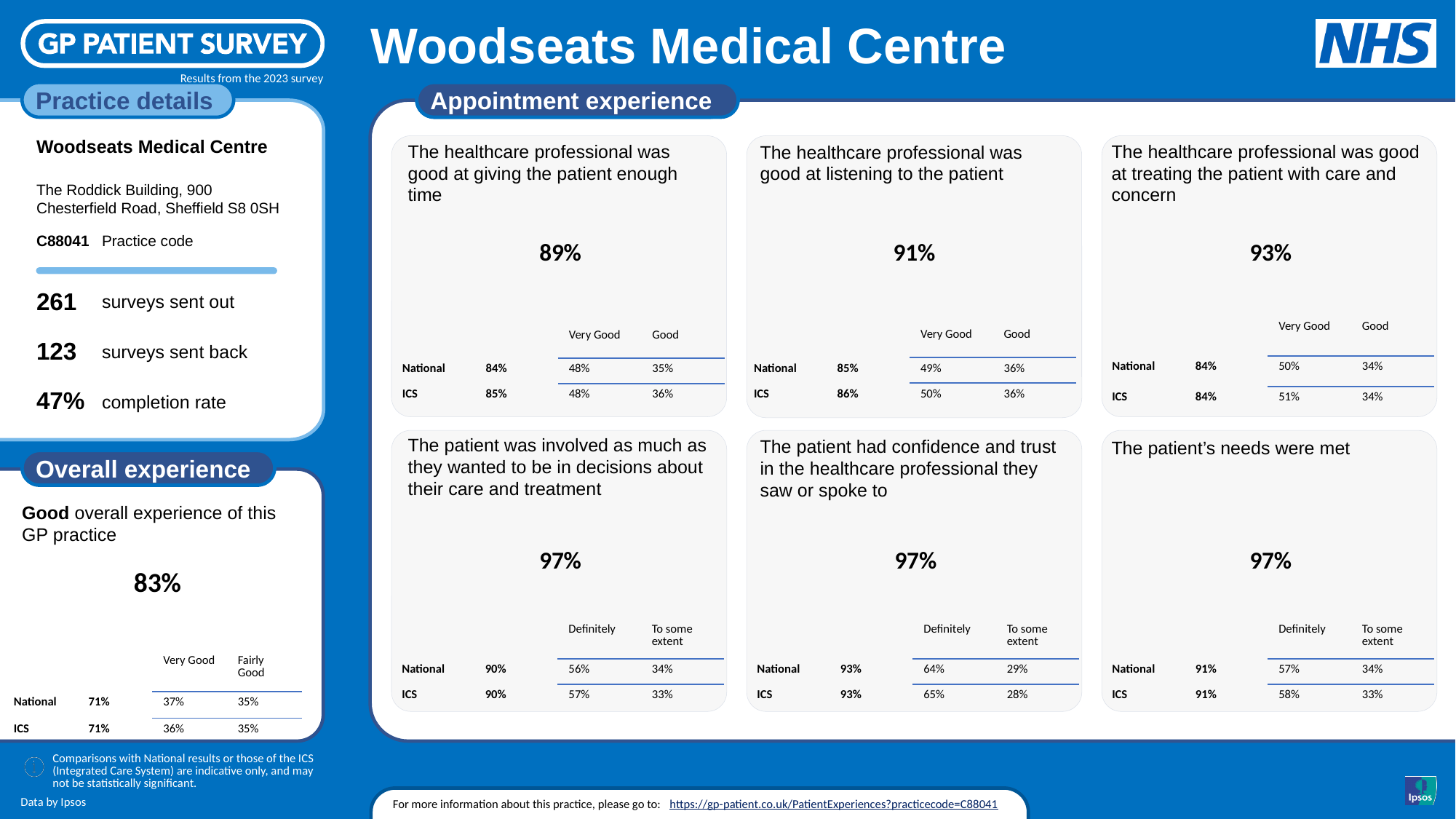
In the panel 'The healthcare professional was good at giving the patient enough time', what is the practice's headline percentage? 89% In the 'Overall experience' panel, what are the two response categories listed in the comparison table? Very Good and Fairly Good How many question panels are shown under the 'Appointment experience' heading? 6 In the 'Overall experience' panel, what is the ICS 'Very Good' value? 36% Among the six 'Appointment experience' panels, which headline percentage is the lowest? 89% (good at giving the patient enough time) In the panel 'The patient's needs were met', what is the difference between the practice's headline percentage (97%) and the National value (91%)? 6 percentage points In the panel 'The healthcare professional was good at listening to the patient', what is the ICS value? 86% In the panel 'The healthcare professional was good at treating the patient with care and concern', what is the National 'Very Good' value? 50% In the 'Overall experience' panel, what is the National value for good overall experience? 71% In the panel 'The healthcare professional was good at giving the patient enough time', which is larger: the National value or the ICS value? ICS (85%) In the panel 'The patient had confidence and trust in the healthcare professional they saw or spoke to', what is the ICS 'Definitely' value? 65% In the 'Overall experience' panel, what percentage of patients reported a good overall experience of this GP practice? 83%